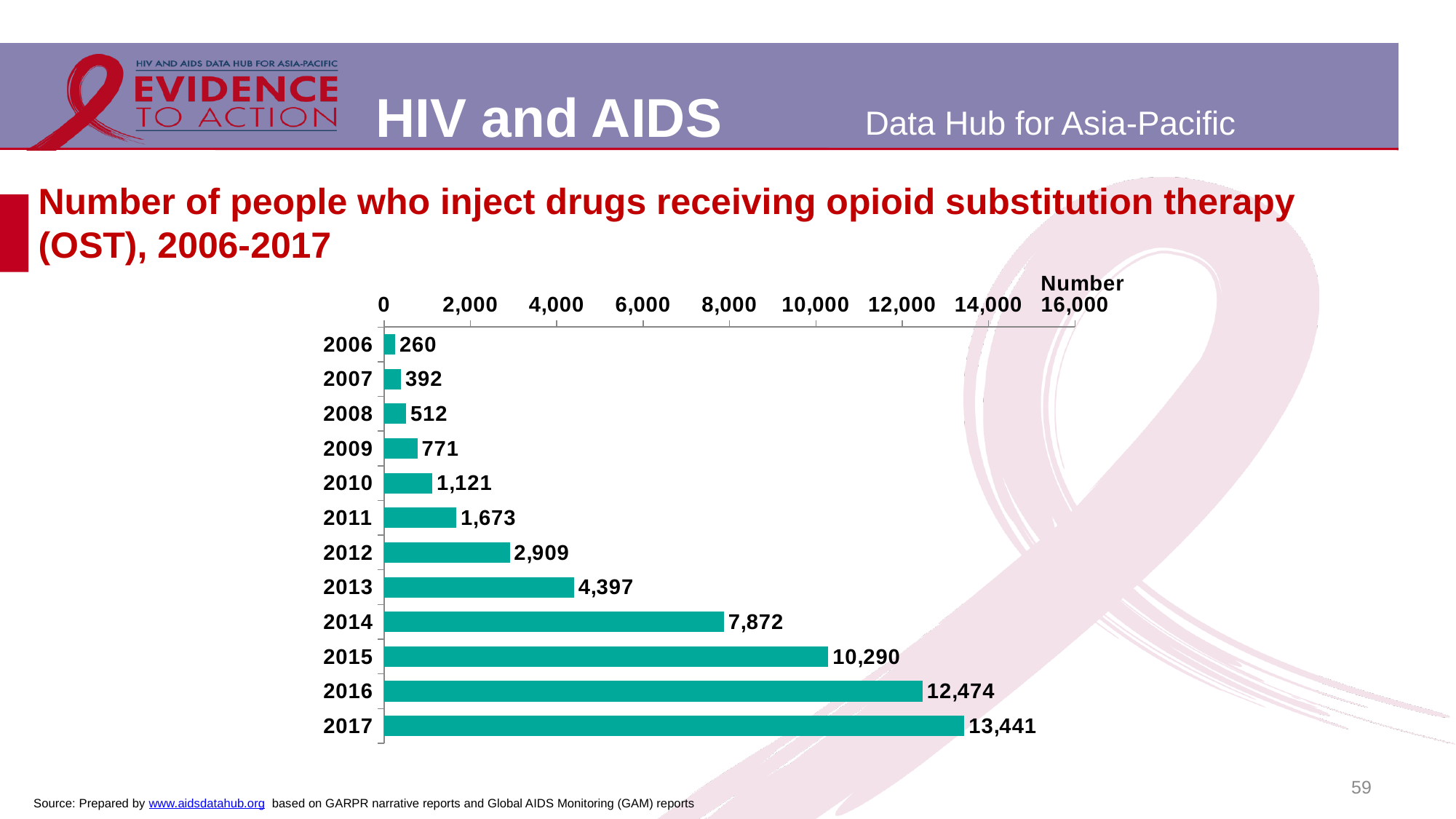
Which year has a larger value, 2012 or 2013? 2013 Which year has the lowest number of people receiving OST? 2006 What is the label on the value axis of the chart? Number Which year has the highest number of people receiving OST? 2017 Do the values rise or fall from 2006 to 2017? Rise What is the difference between the values for 2017 and 2016? 967 How many years are shown in the chart? 12 What is the difference between the values for 2015 and 2014? 2,418 Is the value for 2016 greater or less than 12,000? greater What kind of chart is shown on the slide? Bar chart What is the value shown for 2010? 1,121 What is the number of people who inject drugs receiving OST in 2014? 7,872